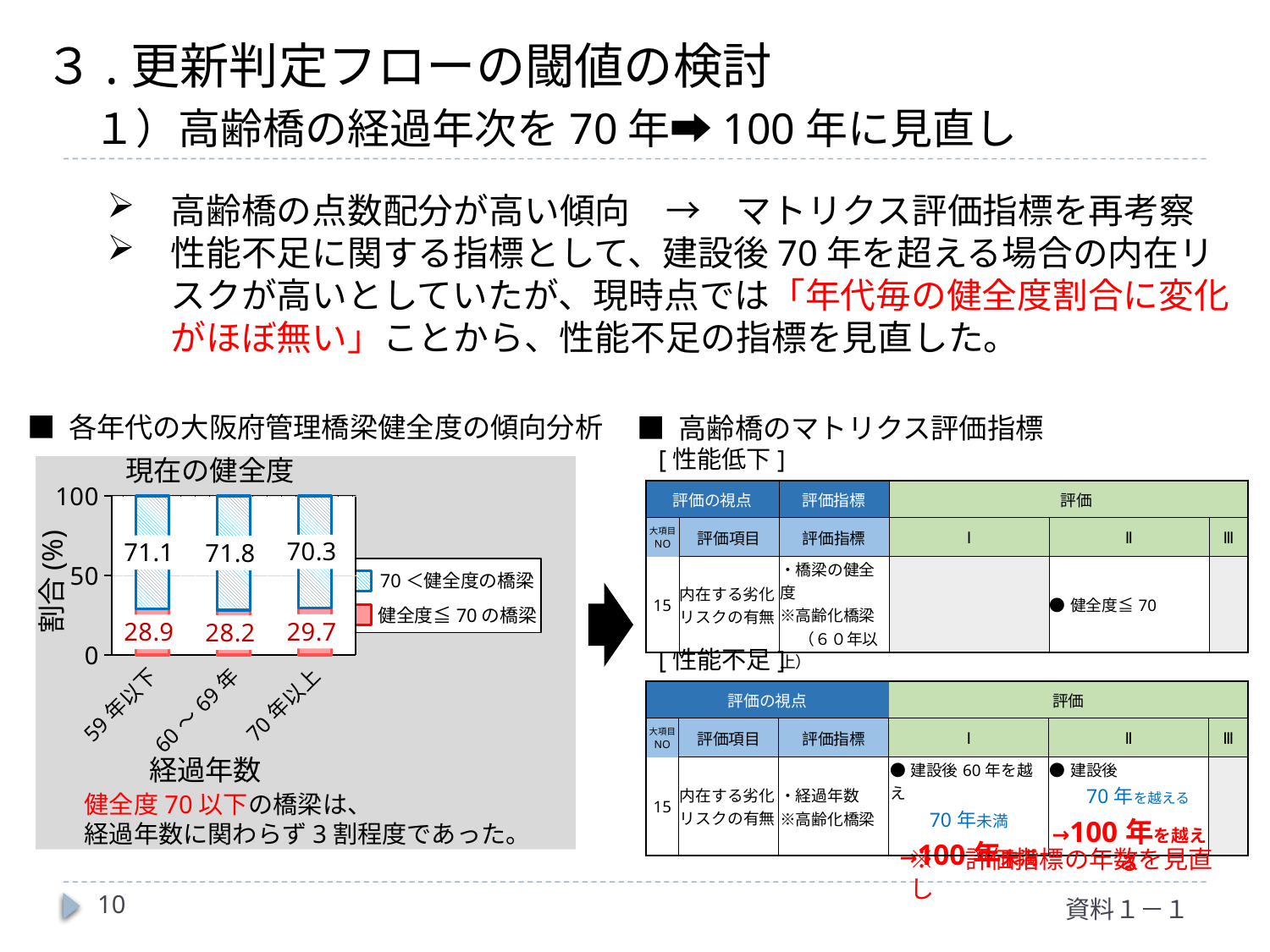
How many categories are shown on the x axis of the 現在の健全度 chart? 3 In the 現在の健全度 chart, which category has the lowest value for 健全度≦70の橋梁? 60～69年 In the 現在の健全度 chart, which category has the highest value for 70＜健全度の橋梁? 60～69年 In the 現在の健全度 chart, what is the value of 70＜健全度の橋梁 for 59年以下? 71.1 What type of chart is shown under 現在の健全度? bar chart In the 現在の健全度 chart, what is the difference between the 健全度≦70の橋梁 values for 70年以上 and 59年以下? 0.8 In the 現在の健全度 chart, what is the value of 健全度≦70の橋梁 for 60～69年? 28.2 In the 現在の健全度 chart, what is the total of the stacked bar for 60～69年? 100 How many series does the legend of the 現在の健全度 chart list? 2 In the 現在の健全度 chart, which is larger: the 70＜健全度の橋梁 value for 59年以下 or for 70年以上? 59年以下 What is the label of the y axis in the 現在の健全度 chart? 割合(%) In the 現在の健全度 chart, what is the value of 健全度≦70の橋梁 for 70年以上? 29.7